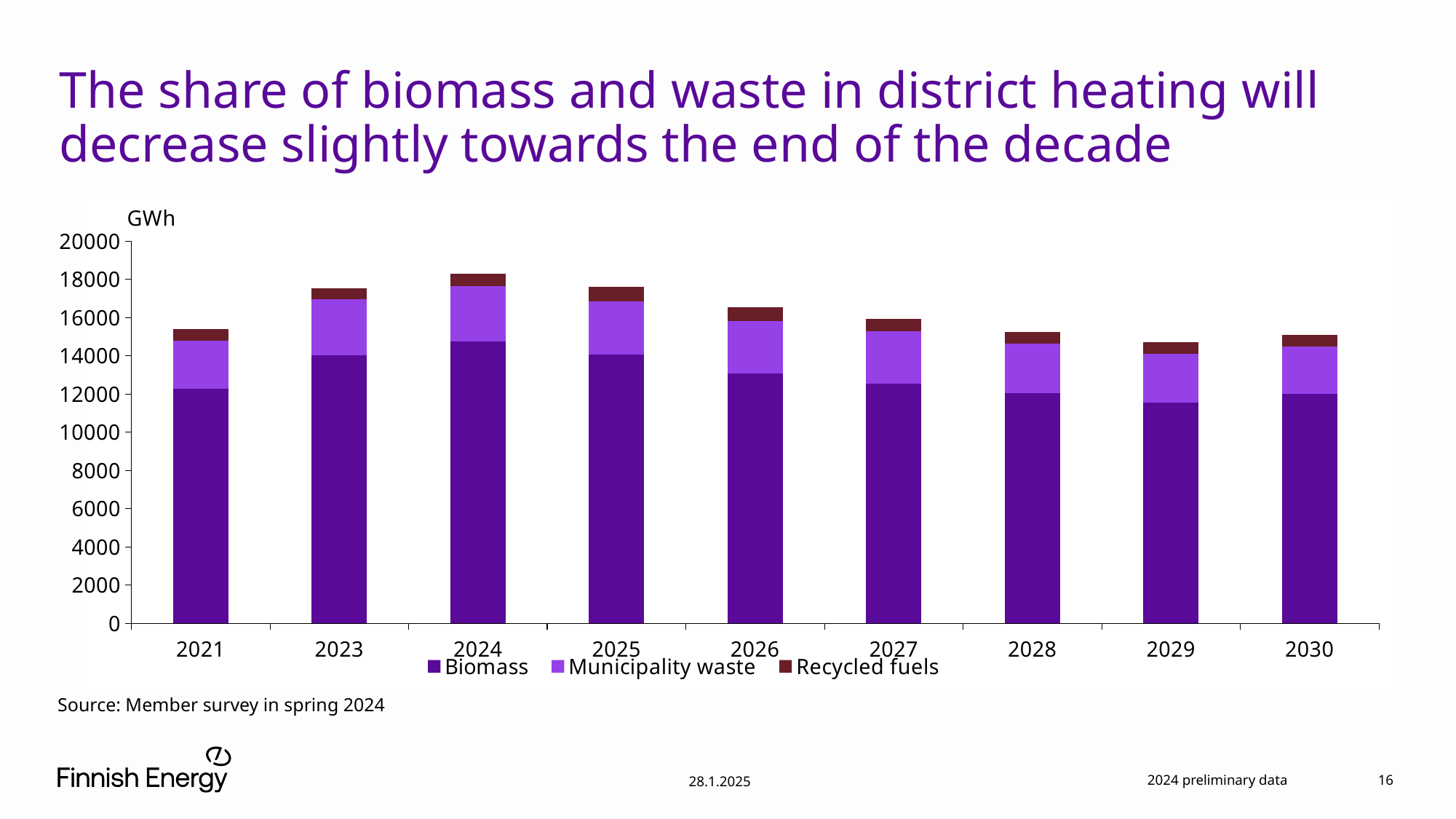
Do the total bars rise or fall from 2024 to 2029? fall What unit is shown on the y axis? GWh How many years are shown on the x axis? 9 Which series is shown in the darkest colour at the top of each bar? Recycled fuels Is the total bar for 2024 greater or less than 16000? greater Is the Biomass value for 2024 greater or less than 14000? greater Is the Biomass value for 2029 greater or less than 12000? less Which year has the larger total bar, 2023 or 2027? 2023 What kind of chart is shown on the slide? Stacked bar chart How many series does the legend list? 3 Which year has the highest total bar? 2024